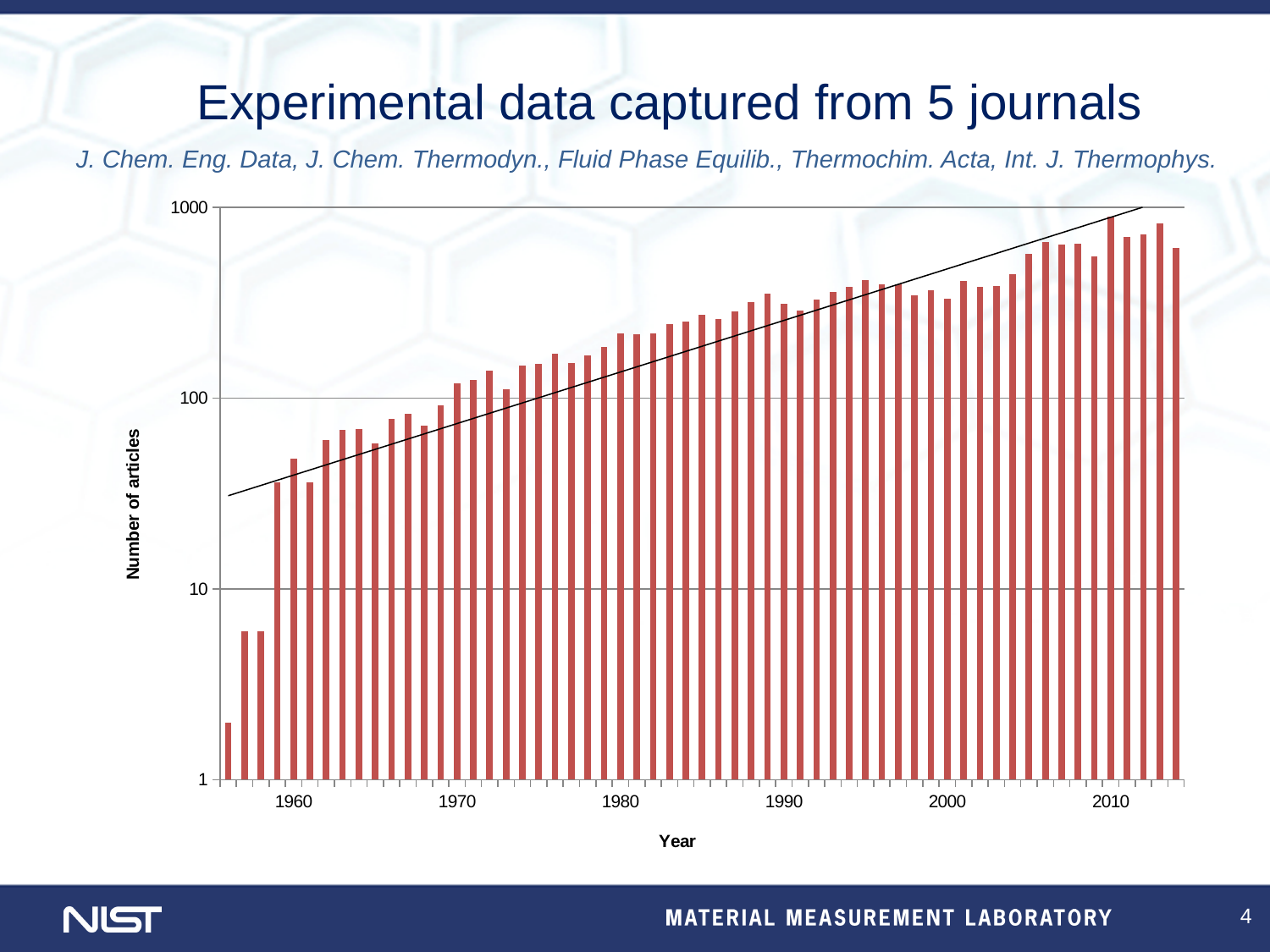
Is the number of articles for 1970 greater or less than 10? greater What kind of chart is shown on the slide? Bar chart Is the number of articles for 1980 greater or less than 100? greater Is the number of articles for 1990 greater or less than 100? greater What is the label of the vertical axis? Number of articles Do the number of articles generally rise or fall from 1960 to 2010? Rise Which year has more articles, 1970 or 1980? 1980 What is the label of the horizontal axis? Year Which year has more articles, 1960 or 2010? 2010